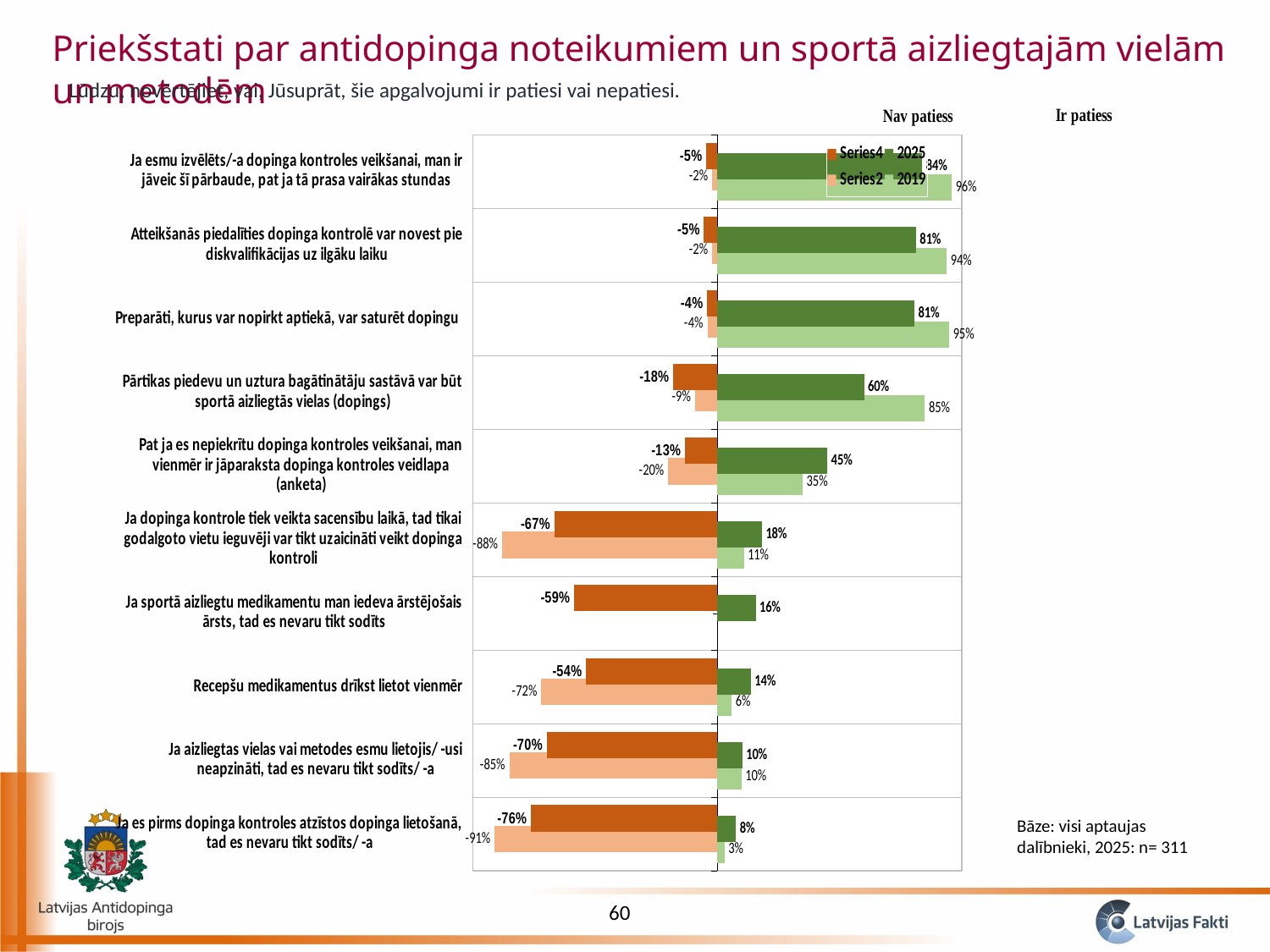
How many statements (categories) are listed on the chart? 10 For 'Pat ja es nepiekrītu dopinga kontroles veikšanai, man vienmēr ir jāparaksta dopinga kontroles veidlapa (anketa)', which year has the larger 'Ir patiess' value, 2025 or 2019? 2025 Which statement has the lowest 2025 'Ir patiess' value? Ja es pirms dopinga kontroles atzīstos dopinga lietošanā, tad es nevaru tikt sodīts/-a What are the two column headings shown above the chart? Nav patiess and Ir patiess What is the difference between the 2019 and 2025 'Ir patiess' values for 'Pārtikas piedevu un uztura bagātinātāju sastāvā var būt sportā aizliegtās vielas (dopings)'? 25% What is the 2025 'Ir patiess' value for 'Ja sportā aizliegtu medikamentu man iedeva ārstējošais ārsts, tad es nevaru tikt sodīts'? 16% What kind of chart is shown on the slide? bar chart For 'Recepšu medikamentus drīkst lietot vienmēr', which year has the larger 'Ir patiess' value, 2025 or 2019? 2025 What is the 2025 'Ir patiess' value for 'Preparāti, kurus var nopirkt aptiekā, var saturēt dopingu'? 81% What is the 2025 'Nav patiess' value for 'Ja es pirms dopinga kontroles atzīstos dopinga lietošanā, tad es nevaru tikt sodīts/-a'? -76% What is the 2019 'Nav patiess' value for 'Ja dopinga kontrole tiek veikta sacensību laikā, tad tikai godalgoto vietu ieguvēji var tikt uzaicināti veikt dopinga kontroli'? -88% What is the 2019 'Ir patiess' value for 'Atteikšanās piedalīties dopinga kontrolē var novest pie diskvalifikācijas uz ilgāku laiku'? 94%